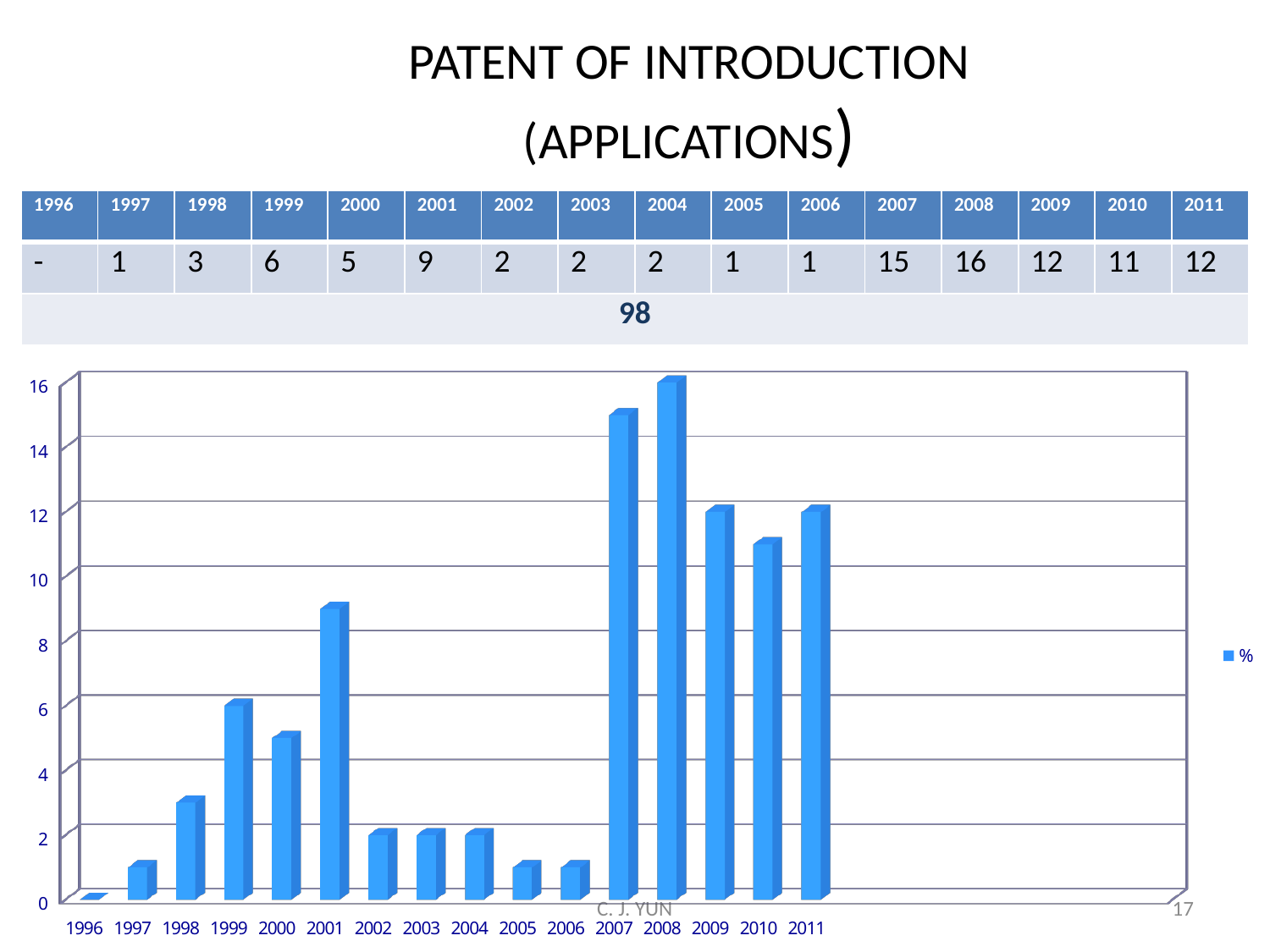
What is the total of all the values shown in the table? 98 What is the legend entry shown for the chart's series? % Is the value for 2010 greater or less than 10? greater How many years are shown on the x axis of the chart? 16 How many series does the chart legend list? 1 Which year has the highest value in the chart? 2008 What is the difference between the values for 2008 and 2007? 1 What is the value for 2007? 15 What is the value for 2008? 16 Which is larger, the value for 2009 or the value for 2010? 2009 What is the value for 2001? 9 What type of chart is shown on the slide? bar chart